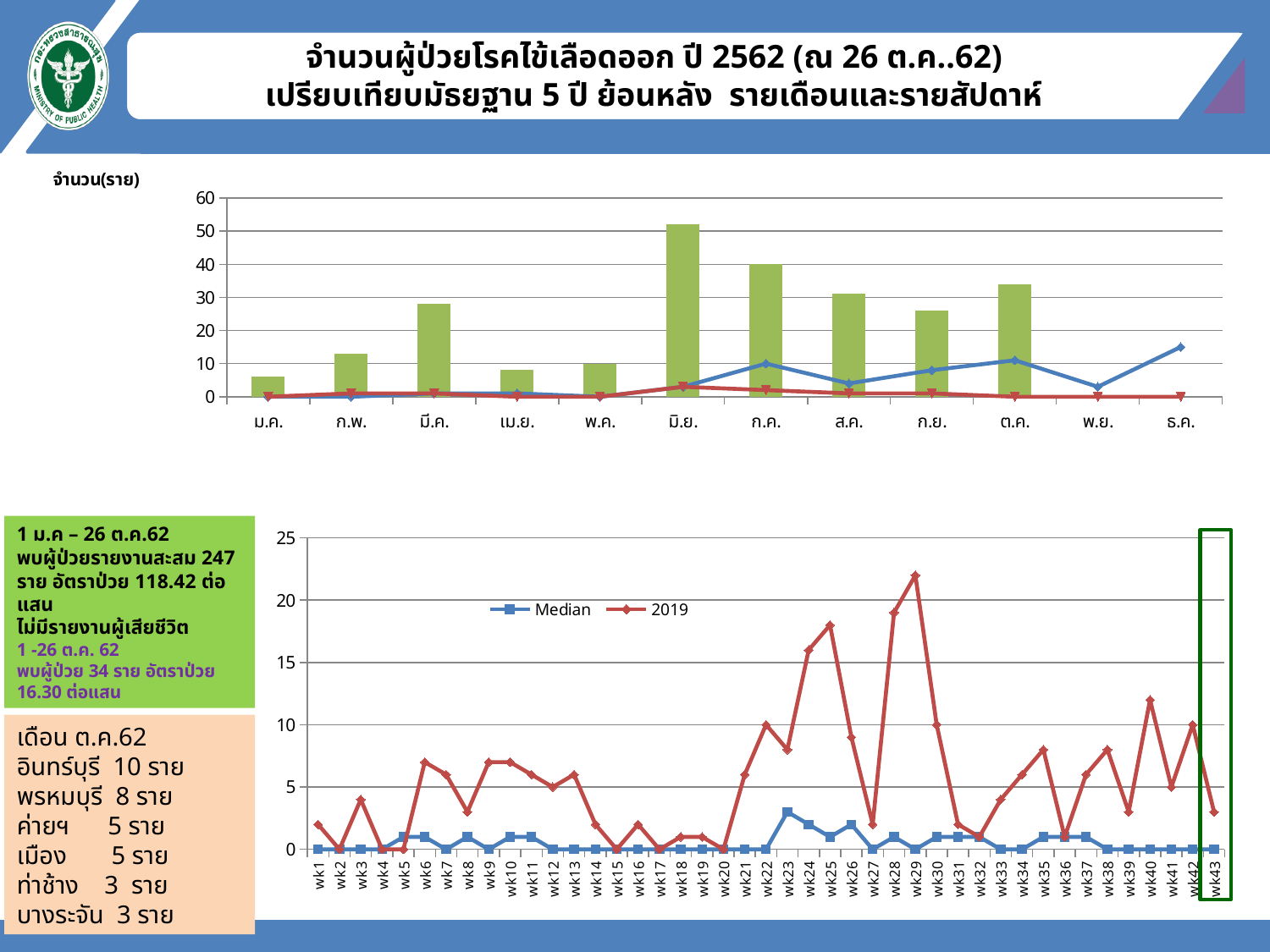
In the bottom weekly chart, which is larger for the 2019 series, the value at wk24 or at wk27? wk24 In the top monthly chart, which bar is taller, มี.ค. or เม.ย.? มี.ค. In the top monthly chart, is the bar for ก.ย. greater or less than 30? less In the bottom weekly chart, is the 2019 value at wk29 greater or less than 20? greater How many series does the legend of the bottom weekly chart list? 2 In the top monthly chart, is the bar for ต.ค. greater or less than 30? greater In the bottom weekly chart, at which week does the 2019 series reach its highest point? wk29 How many month categories are shown on the x axis of the top chart? 12 In the top monthly chart, which month has the tallest bar? มิ.ย. What kind of chart is the bottom weekly chart? line chart What are the two series named in the legend of the bottom weekly chart? Median and 2019